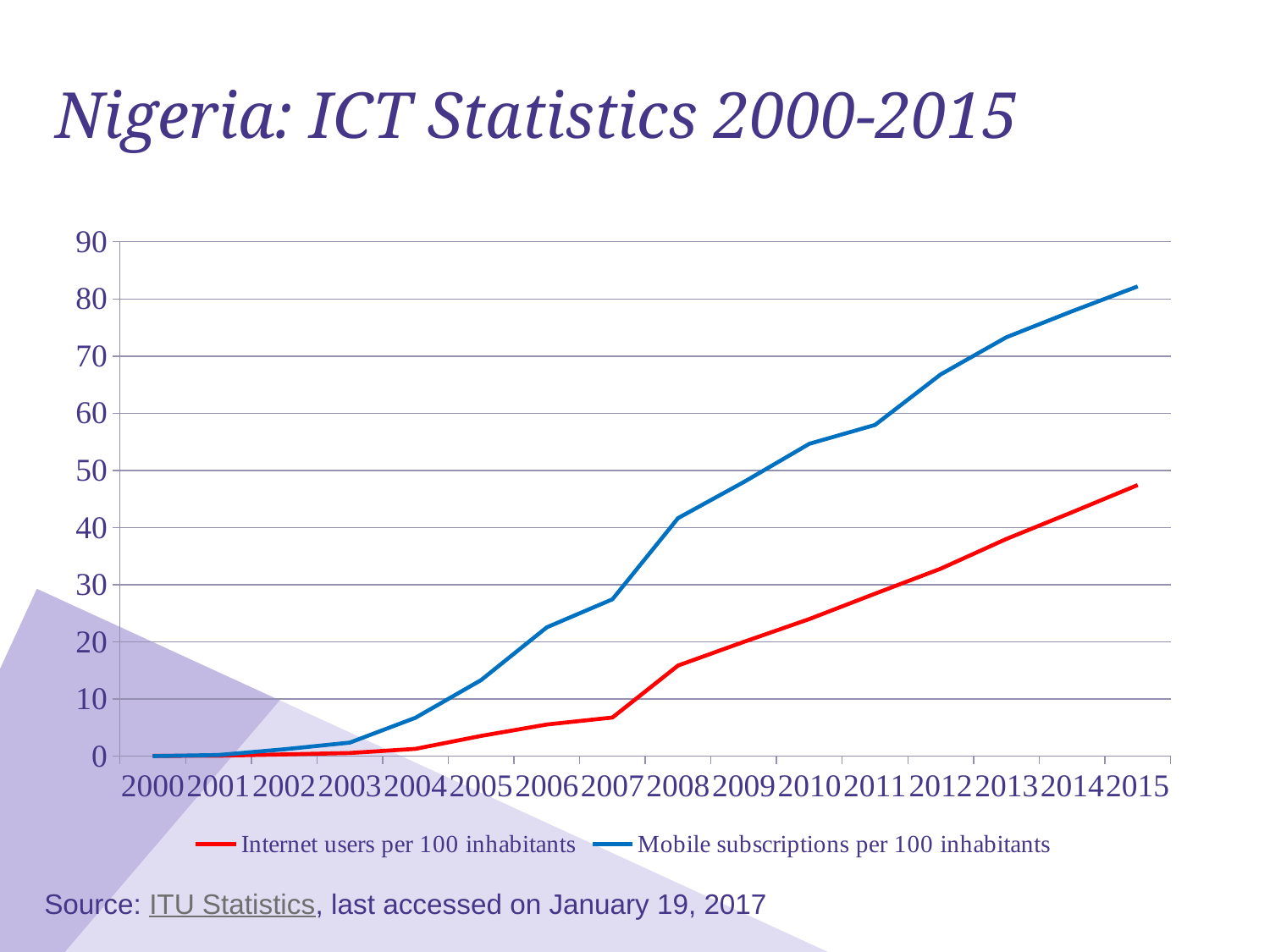
What colour is the line for Mobile subscriptions per 100 inhabitants? Blue How many years are plotted along the x axis? 16 Is the value for Internet users per 100 inhabitants in 2015 greater or less than 50? less Which series has the higher value in 2015, Internet users per 100 inhabitants or Mobile subscriptions per 100 inhabitants? Mobile subscriptions per 100 inhabitants Is the value for Mobile subscriptions per 100 inhabitants in 2012 greater or less than 60? greater What kind of chart is shown on the slide? Line chart Is the value for Internet users per 100 inhabitants in 2007 greater or less than 10? less How many series does the legend list? 2 In which year does Mobile subscriptions per 100 inhabitants reach its highest value? 2015 Do the values for Internet users per 100 inhabitants rise or fall from 2000 to 2015? Rise